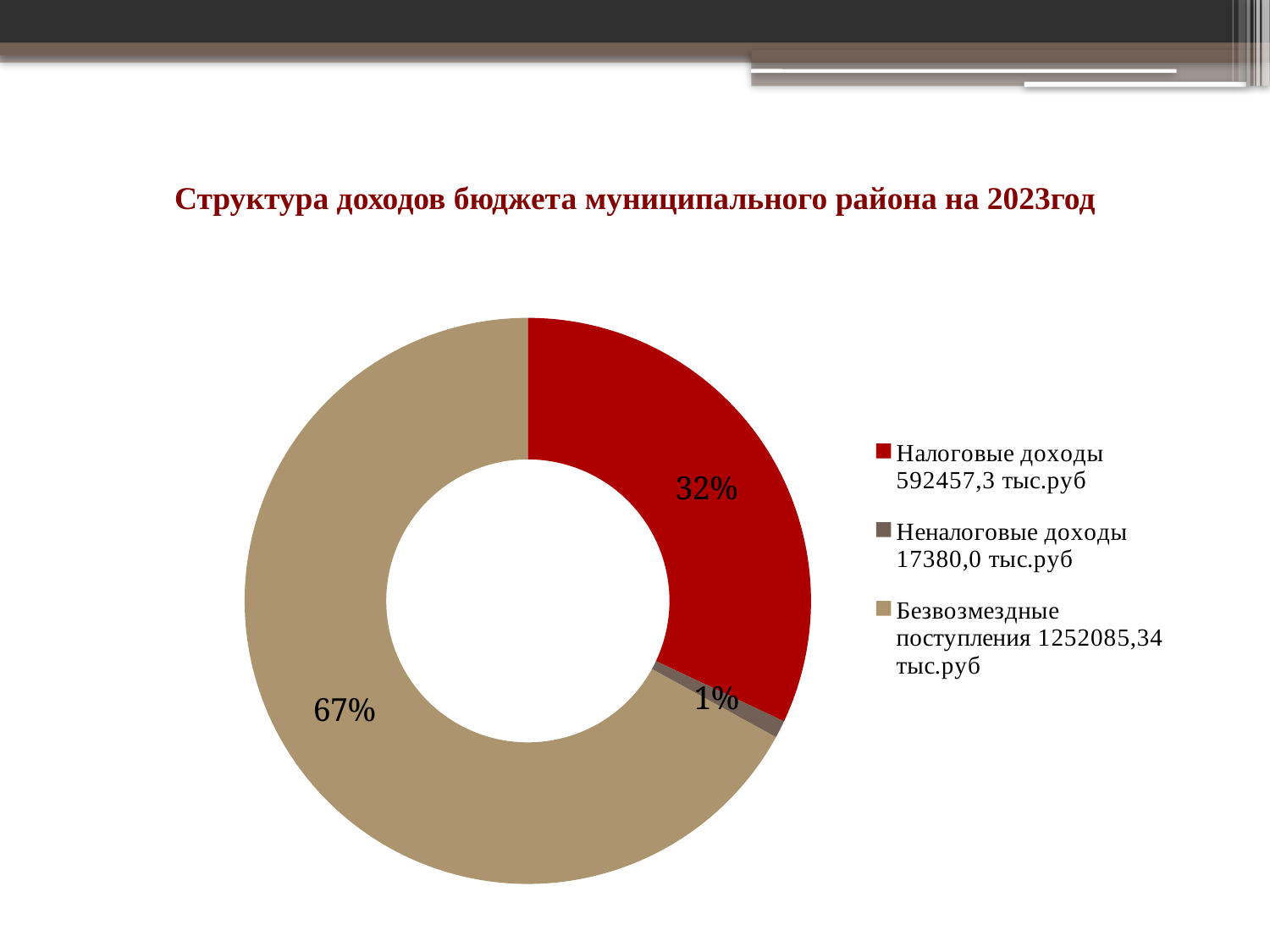
What kind of chart is shown on the slide? Doughnut (pie) chart According to the legend, what amount in тыс.руб is given for Налоговые доходы? 592457,3 тыс.руб How many categories does the chart show? 3 Which category has the largest share of the chart? Безвозмездные поступления What is the difference in percentage points between the shares of Безвозмездные поступления and Налоговые доходы? 35 percentage points What colour is the slice for Безвозмездные поступления? Tan (beige) Which is larger: the share of Налоговые доходы or the share of Неналоговые доходы? Налоговые доходы Which category has the smallest share of the chart? Неналоговые доходы What is the title of the chart? Структура доходов бюджета муниципального района на 2023год What share of the chart does Налоговые доходы take? 32% What share of the chart does Неналоговые доходы take? 1% What share of the chart does Безвозмездные поступления take? 67%